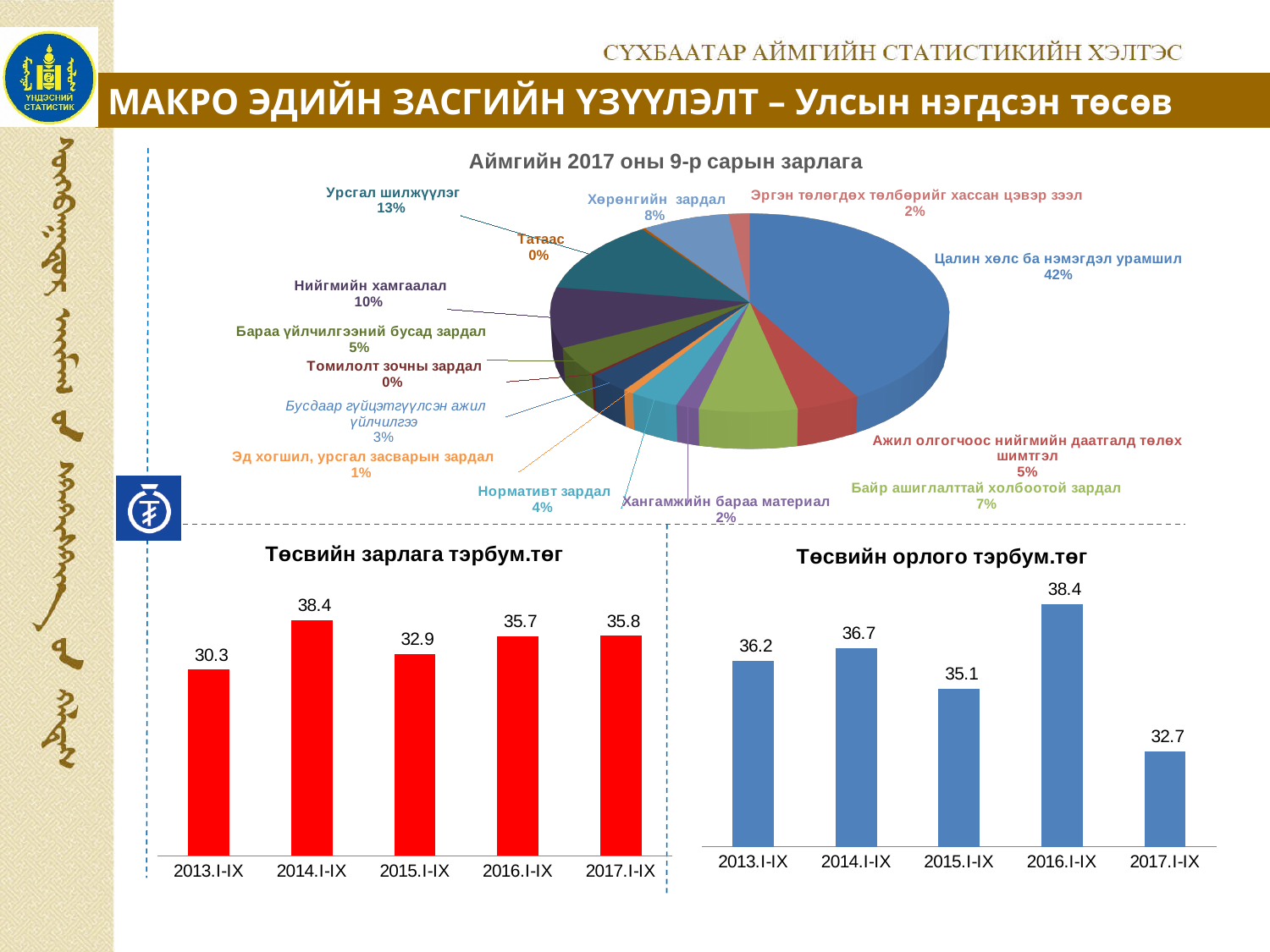
In the pie chart 'Аймгийн 2017 оны 9-р сарын зарлага', what share does 'Урсгал шилжүүлэг' have? 13% In the pie chart 'Аймгийн 2017 оны 9-р сарын зарлага', what share does 'Нийгмийн хамгаалал' have? 10% In the bar chart 'Төсвийн орлого тэрбум.төг', which period has the lowest value? 2017.I-IX In the bar chart 'Төсвийн орлого тэрбум.төг', what is the value for 2017.I-IX? 32.7 In the bar chart 'Төсвийн зарлага тэрбум.төг', how many periods are shown? 5 In the bar chart 'Төсвийн зарлага тэрбум.төг', what is the difference between 2014.I-IX and 2013.I-IX? 8.1 In the bar chart 'Төсвийн зарлага тэрбум.төг', which period has the highest value? 2014.I-IX In the bar chart 'Төсвийн орлого тэрбум.төг', which is larger, 2014.I-IX or 2015.I-IX? 2014.I-IX In the bar chart 'Төсвийн зарлага тэрбум.төг', what is the value for 2013.I-IX? 30.3 In the pie chart 'Аймгийн 2017 оны 9-р сарын зарлага', which category has the largest share? Цалин хөлс ба нэмэгдэл урамшил In the pie chart 'Аймгийн 2017 оны 9-р сарын зарлага', what share does 'Цалин хөлс ба нэмэгдэл урамшил' have? 42% What type of chart is 'Аймгийн 2017 оны 9-р сарын зарлага'? Pie chart